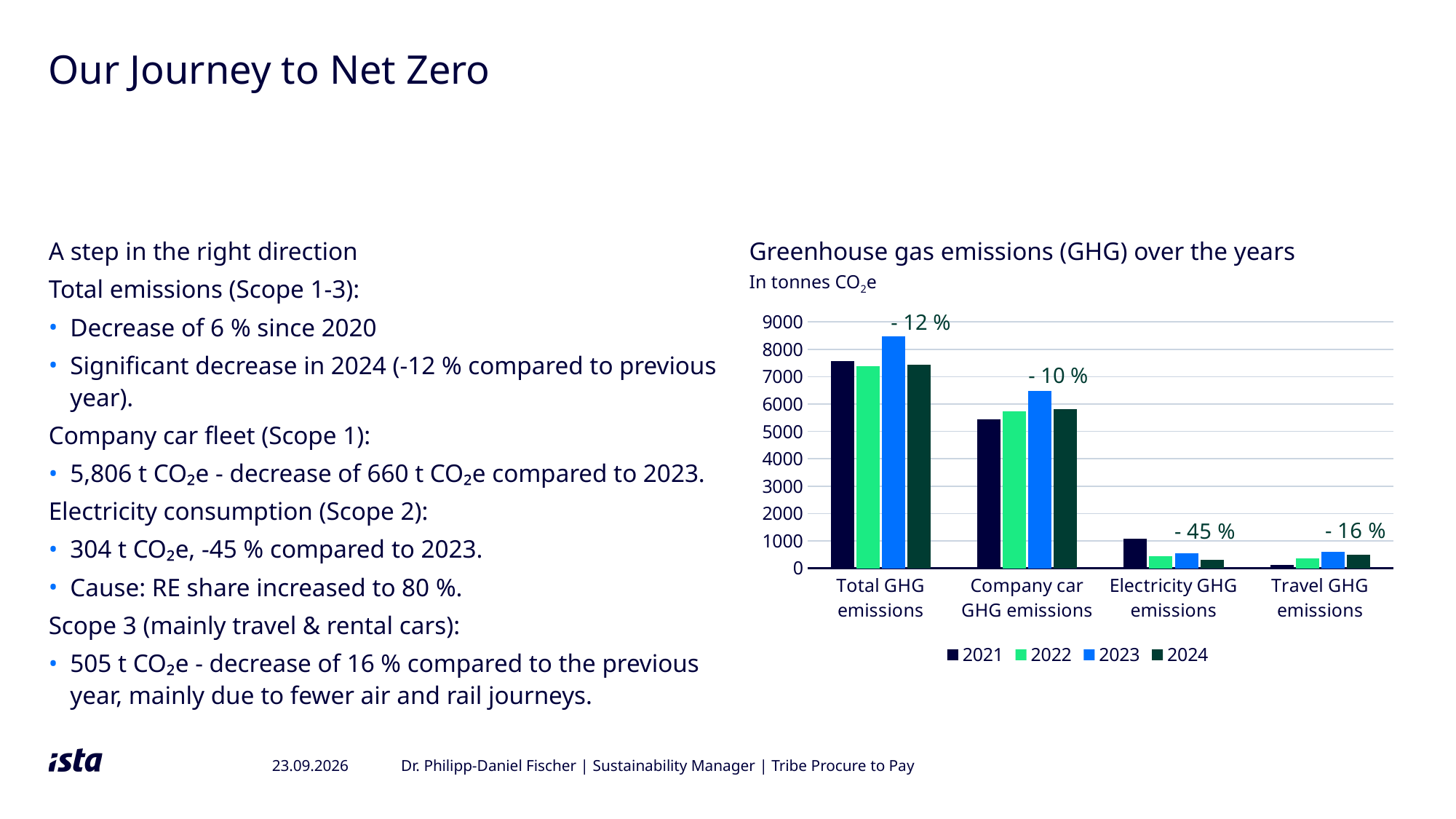
Is the 2022 value for Electricity GHG emissions greater or less than 1000? less Is the 2023 value for Company car GHG emissions greater or less than 6000? greater Is the 2023 value for Total GHG emissions greater or less than 8000? greater What kind of chart is shown on the slide? bar chart What percentage change is annotated above the Electricity GHG emissions bars? - 45 % Which is larger for Electricity GHG emissions, the 2021 bar or the 2024 bar? 2021 How many series does the chart legend list? 4 What is the title of the chart? Greenhouse gas emissions (GHG) over the years Which year has the highest bar for Total GHG emissions? 2023 How many categories are shown on the x axis of the chart? 4 Which year has the highest bar for Electricity GHG emissions? 2021 Which category has the lowest bars overall in the chart? Travel GHG emissions